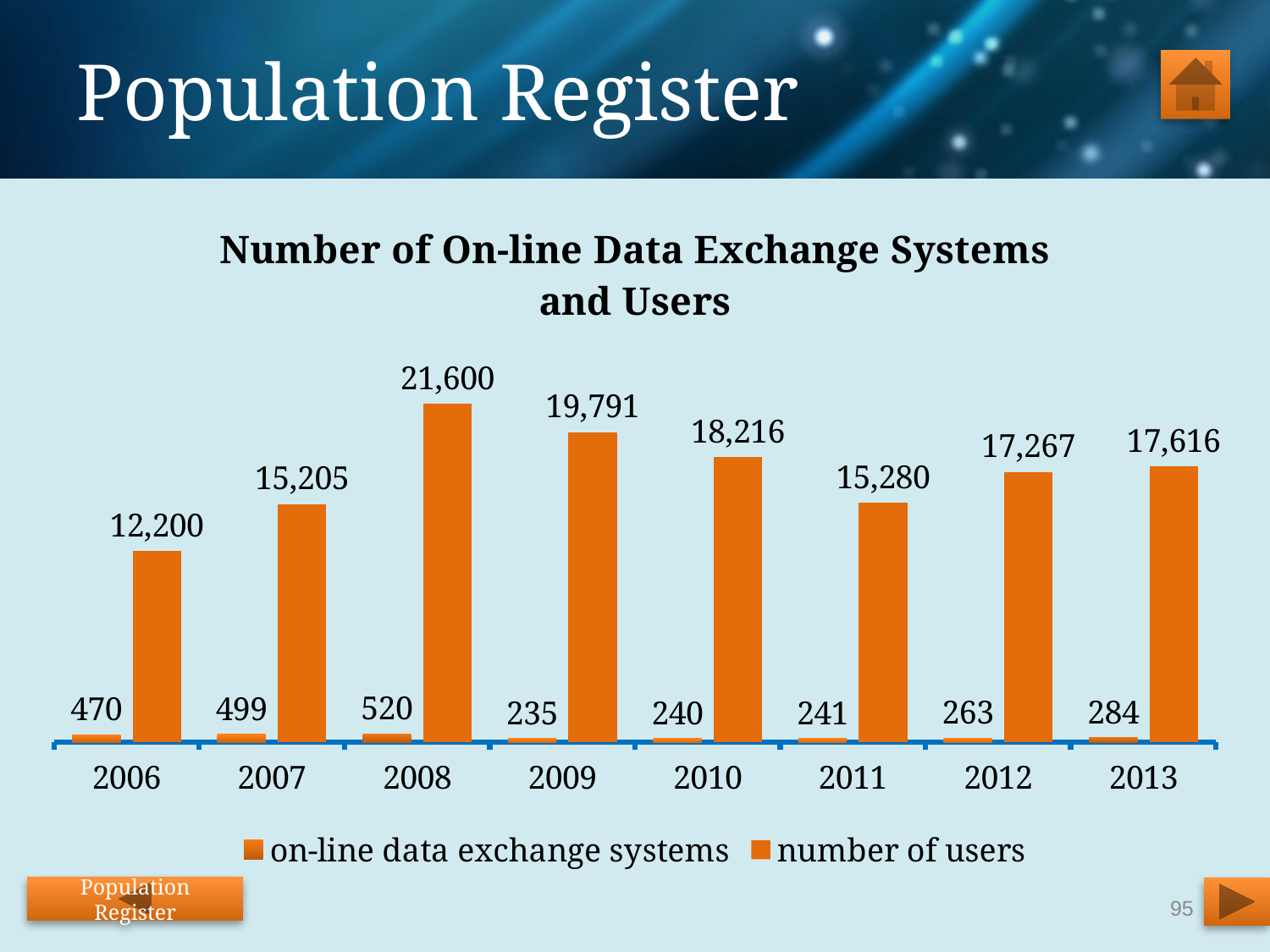
What kind of chart is shown on the slide? bar chart Does the number of users rise or fall from 2011 to 2013? rise What is the number of on-line data exchange systems in 2013? 284 What is the difference in the number of on-line data exchange systems between 2008 and 2006? 50 What is the number of users in 2008? 21,600 How many series does the legend list? 2 What is the title of the chart? Number of On-line Data Exchange Systems and Users Which year has the highest number of users? 2008 How many years are shown on the x axis? 8 What is the difference in the number of users between 2008 and 2009? 1,809 Which year has more users, 2010 or 2011? 2010 Which year has the lowest number of on-line data exchange systems? 2009